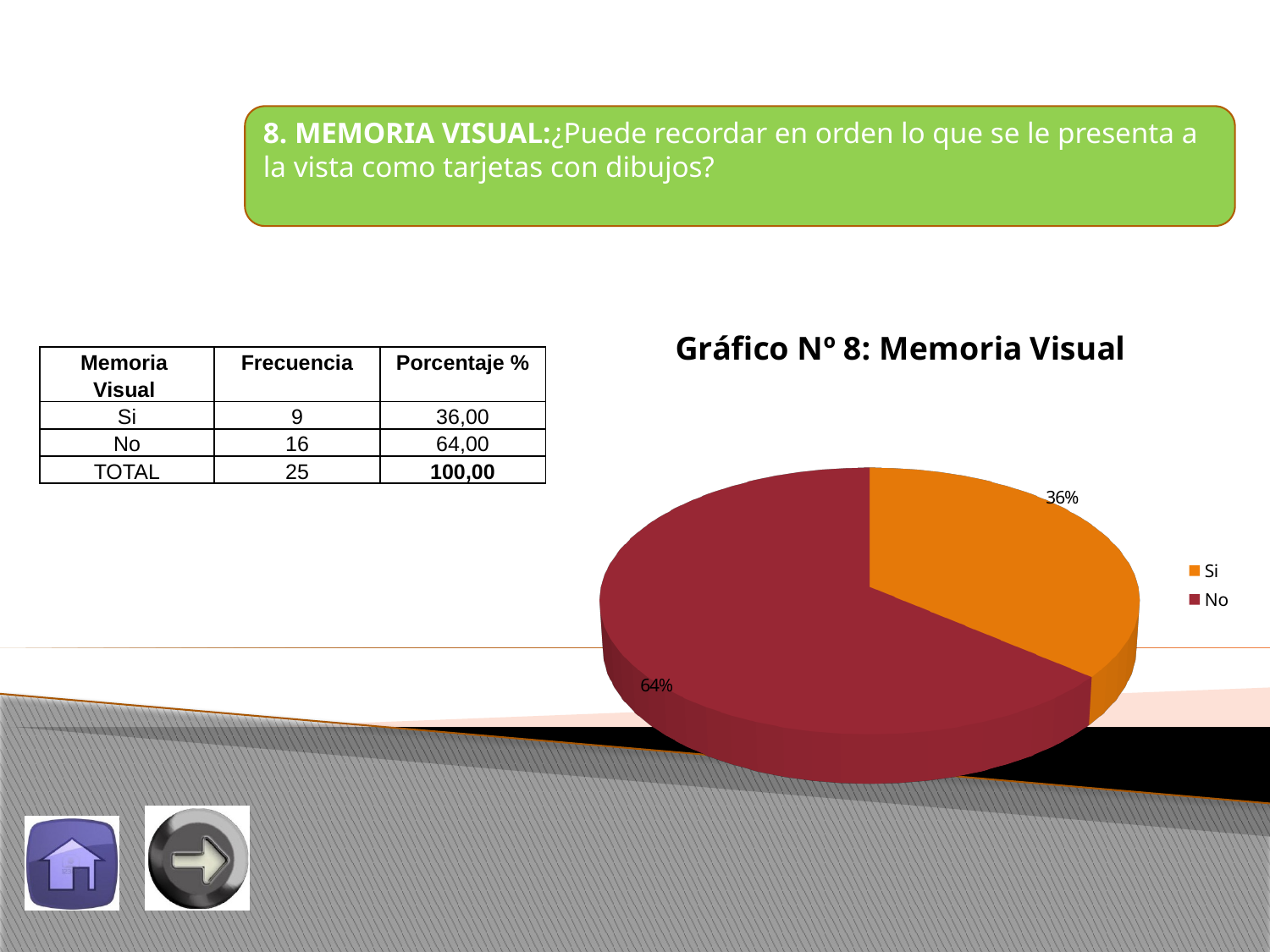
What is the title of the chart? Gráfico Nº 8: Memoria Visual How many entries does the legend of the pie chart list? 2 What colour is the "Si" slice in the pie chart? Orange Which slice is larger, "Si" or "No"? No How many slices does the pie chart have? 2 What percentage does the "Si" slice show in the pie chart? 36% What kind of chart is shown on the slide? Pie chart What share of the pie does the "No" slice represent? 64% Which category has the largest slice in the pie chart? No What percentage does the "No" slice show in the pie chart? 64% What is the difference in percentage points between the "No" slice and the "Si" slice? 28 Which category has the smallest slice in the pie chart? Si